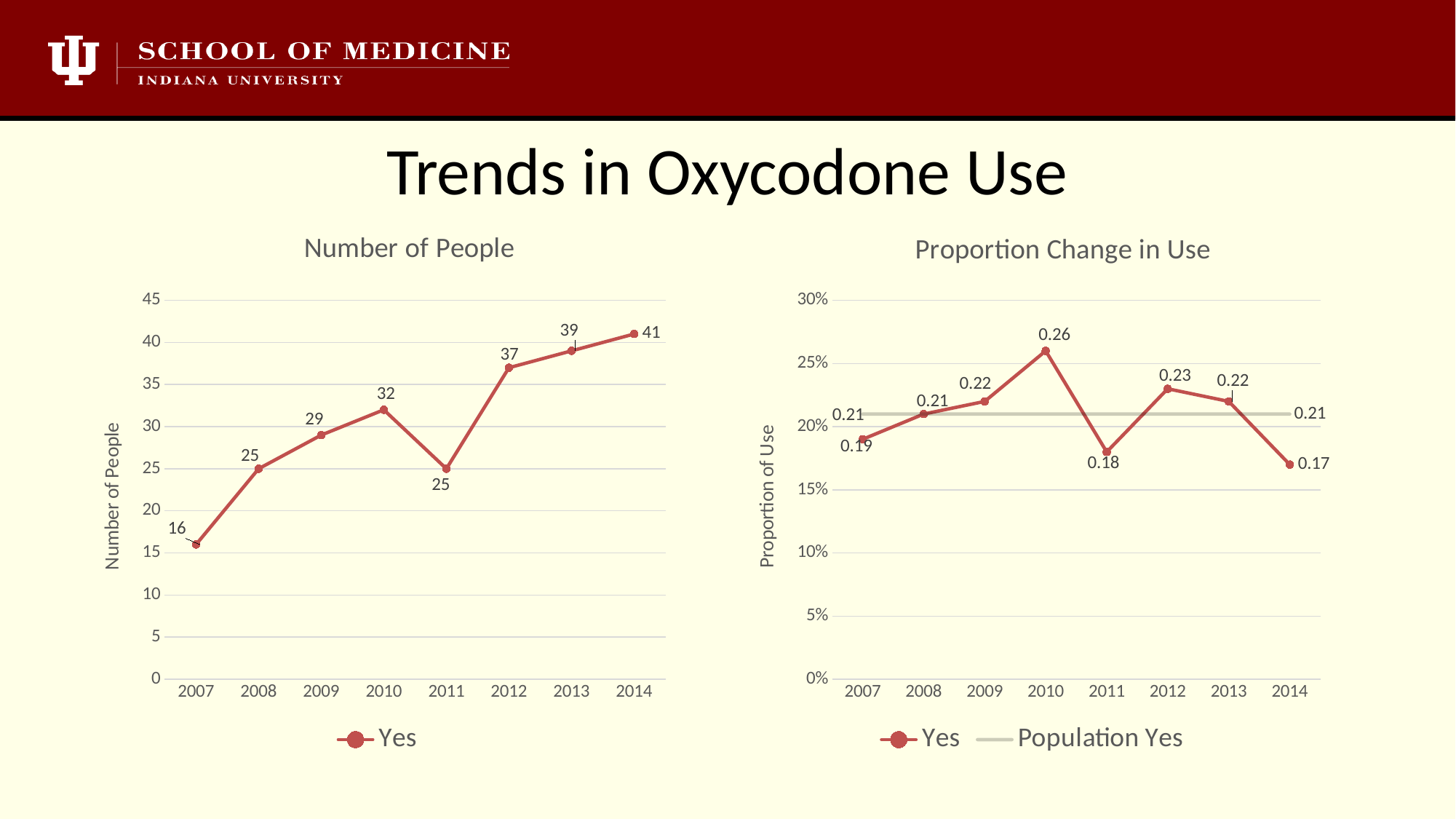
In the 'Proportion Change in Use' chart, is the 'Yes' value for 2012 larger or smaller than the 'Yes' value for 2011? larger In the 'Number of People' chart, what is the value for 2010? 32 In the 'Proportion Change in Use' chart, what is the 'Yes' value for 2010? 0.26 In the 'Number of People' chart, is the value for 2012 greater or less than 35? greater In the 'Number of People' chart, what is the difference between the values for 2014 and 2007? 25 In the 'Proportion Change in Use' chart, which year has the lowest 'Yes' value? 2014 In the 'Number of People' chart, which year has the lowest value? 2007 In the 'Number of People' chart, which year has the highest value? 2014 What kind of chart is the 'Number of People' chart? line chart In the 'Number of People' chart, how many years are plotted on the x axis? 8 In the 'Proportion Change in Use' chart, what is the value of the 'Population Yes' line? 0.21 How many series does the legend of the 'Proportion Change in Use' chart list? 2